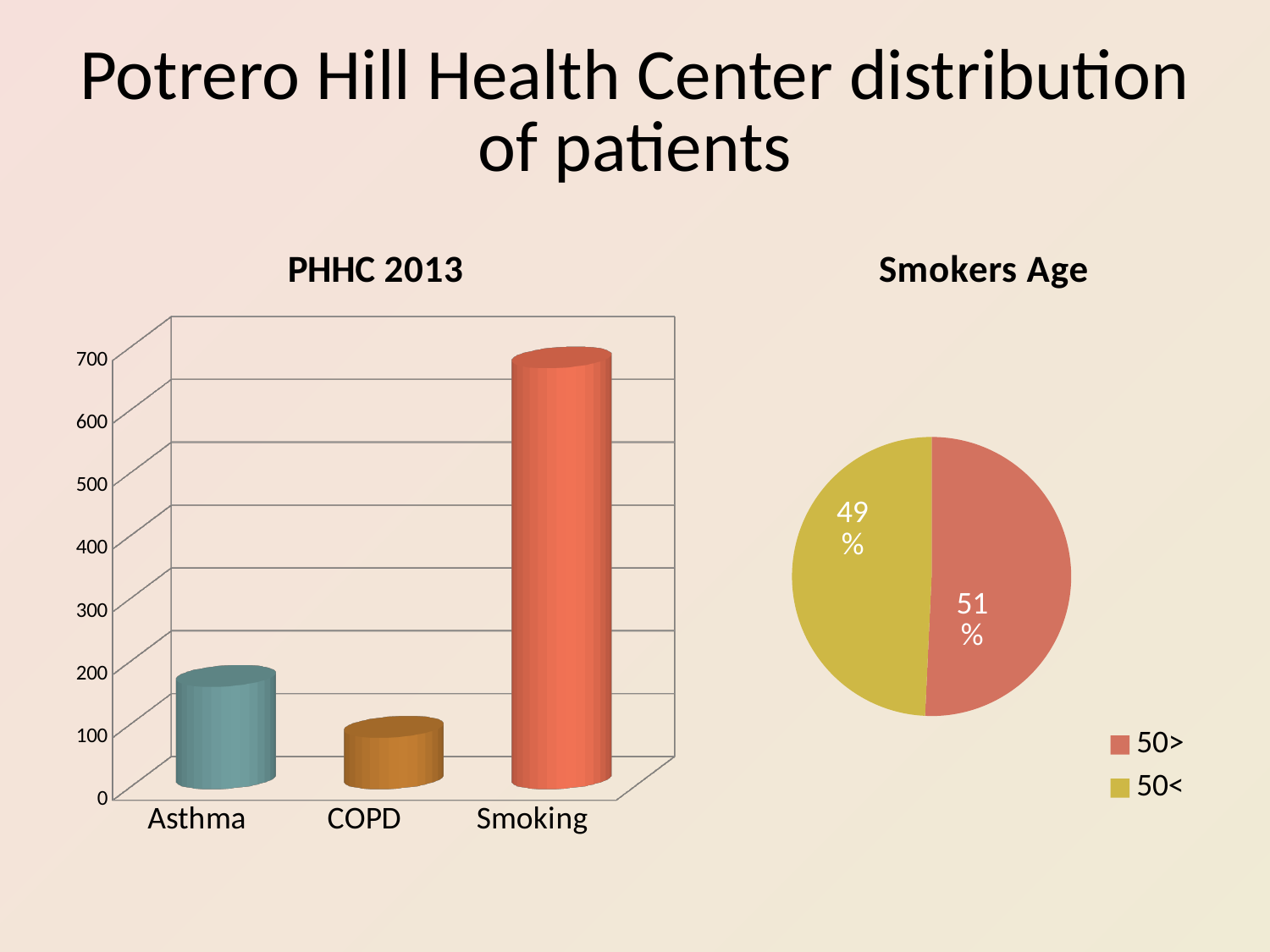
In the Smokers Age chart, what share of the pie is the 50< slice? 49% In the PHHC 2013 chart, is the value for Asthma greater or less than 200? less In the PHHC 2013 chart, which category has the highest value? Smoking What kind of chart is the Smokers Age chart? pie chart In the PHHC 2013 chart, is the value for COPD greater or less than 100? less In the PHHC 2013 chart, is the value for Smoking greater or less than 600? greater How many categories are shown in the PHHC 2013 chart? 3 In the PHHC 2013 chart, which category has the lowest value? COPD What kind of chart is the PHHC 2013 chart? bar chart In the PHHC 2013 chart, which is larger, the value for Asthma or the value for COPD? Asthma How many entries does the legend of the Smokers Age chart list? 2 In the Smokers Age chart, what share of the pie is the 50> slice? 51%